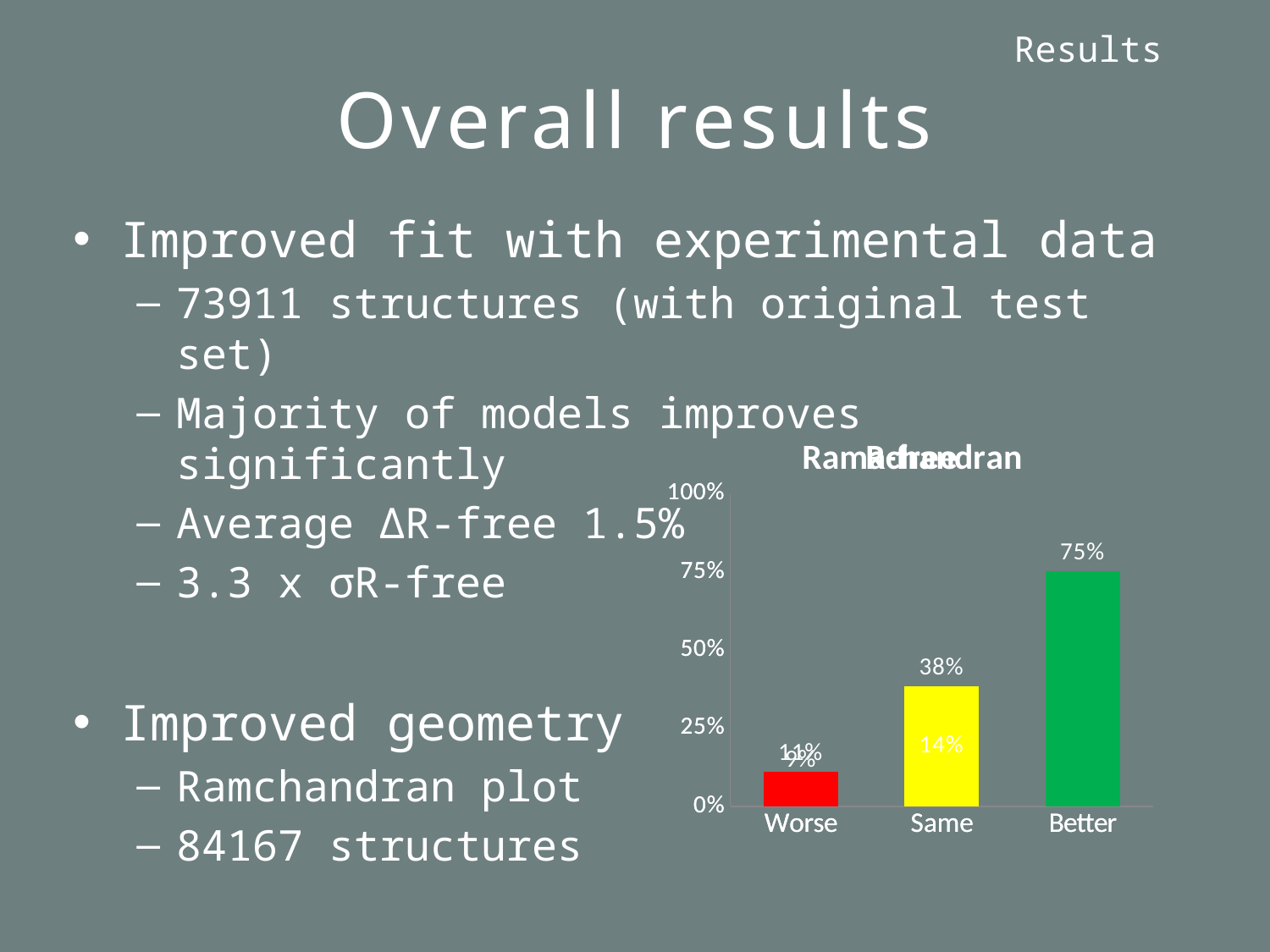
Which category has the lowest value in the bar chart? Worse What kind of chart is shown on the slide? bar chart Which category has the highest value in the bar chart? Better Is the value for Worse greater or less than 25%? less What colour is the bar for Better? green What is the highest tick value shown on the y axis of the chart? 100% How many categories are shown on the x axis of the bar chart? 3 Which is larger, the value for Better or the value for Same? Better What is the value for Better in the bar chart? 75% Is the value for Same greater or less than 50%? less Do the values rise or fall from Worse to Better along the x axis? rise Is the value for Better greater or less than 50%? greater